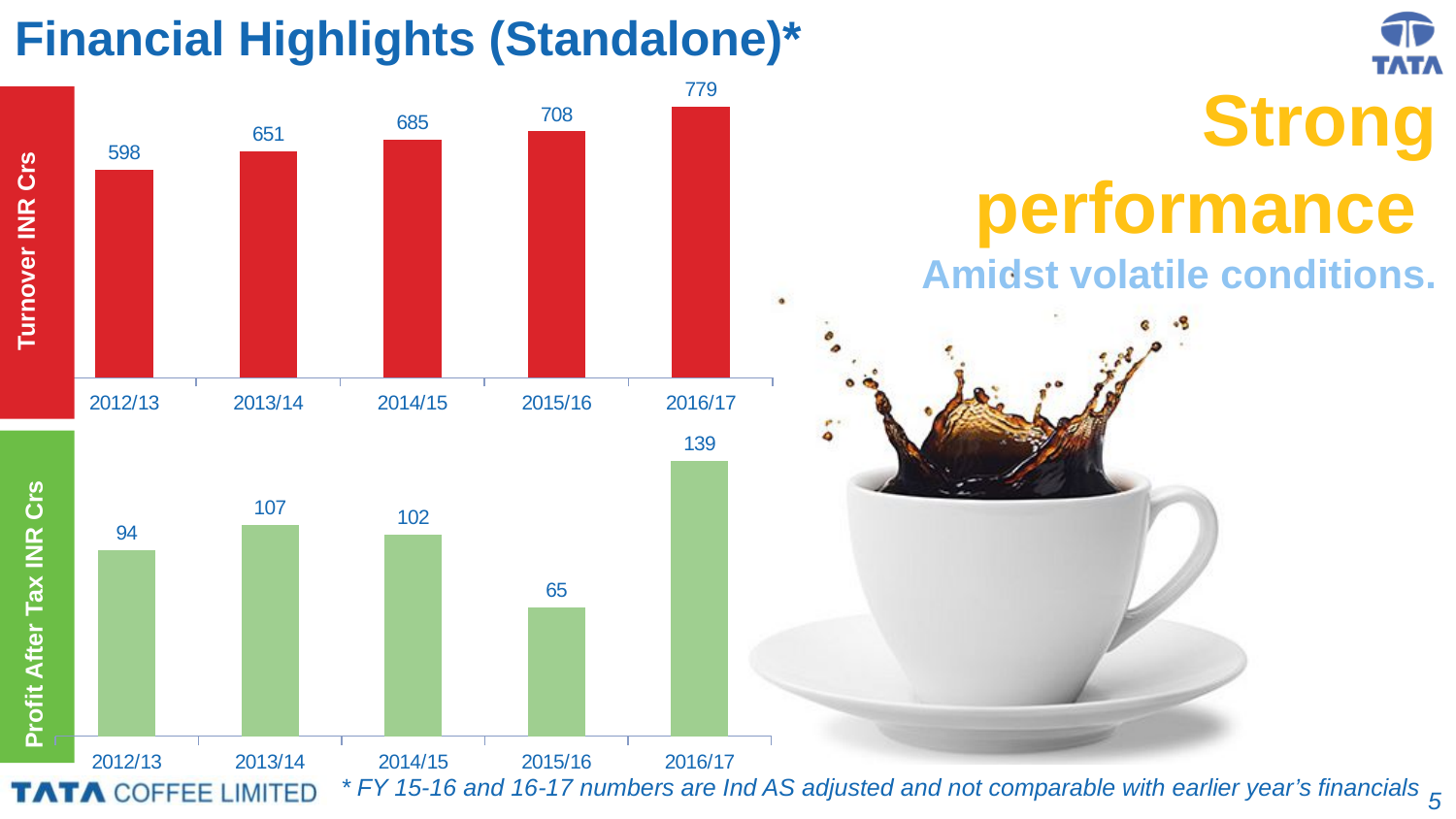
In the Profit After Tax INR Crs chart, what is the profit after tax for 2015/16? 65 In the Profit After Tax INR Crs chart, which year has the lowest profit after tax? 2015/16 In the Profit After Tax INR Crs chart, which year has the highest profit after tax? 2016/17 How many years are shown in the Turnover INR Crs chart? 5 What type of chart is the Turnover INR Crs chart? Bar chart In the Turnover INR Crs chart, what is the turnover for 2012/13? 598 In the Turnover INR Crs chart, what is the difference in turnover between 2016/17 and 2015/16? 71 In the Turnover INR Crs chart, what is the turnover for 2016/17? 779 In the Turnover INR Crs chart, does turnover rise or fall from 2012/13 to 2016/17? Rise In the Profit After Tax INR Crs chart, what is the difference in profit after tax between 2013/14 and 2014/15? 5 In the Turnover INR Crs chart, which year has the lowest turnover? 2012/13 In the Profit After Tax INR Crs chart, which is larger: the profit after tax for 2012/13 or 2013/14? 2013/14